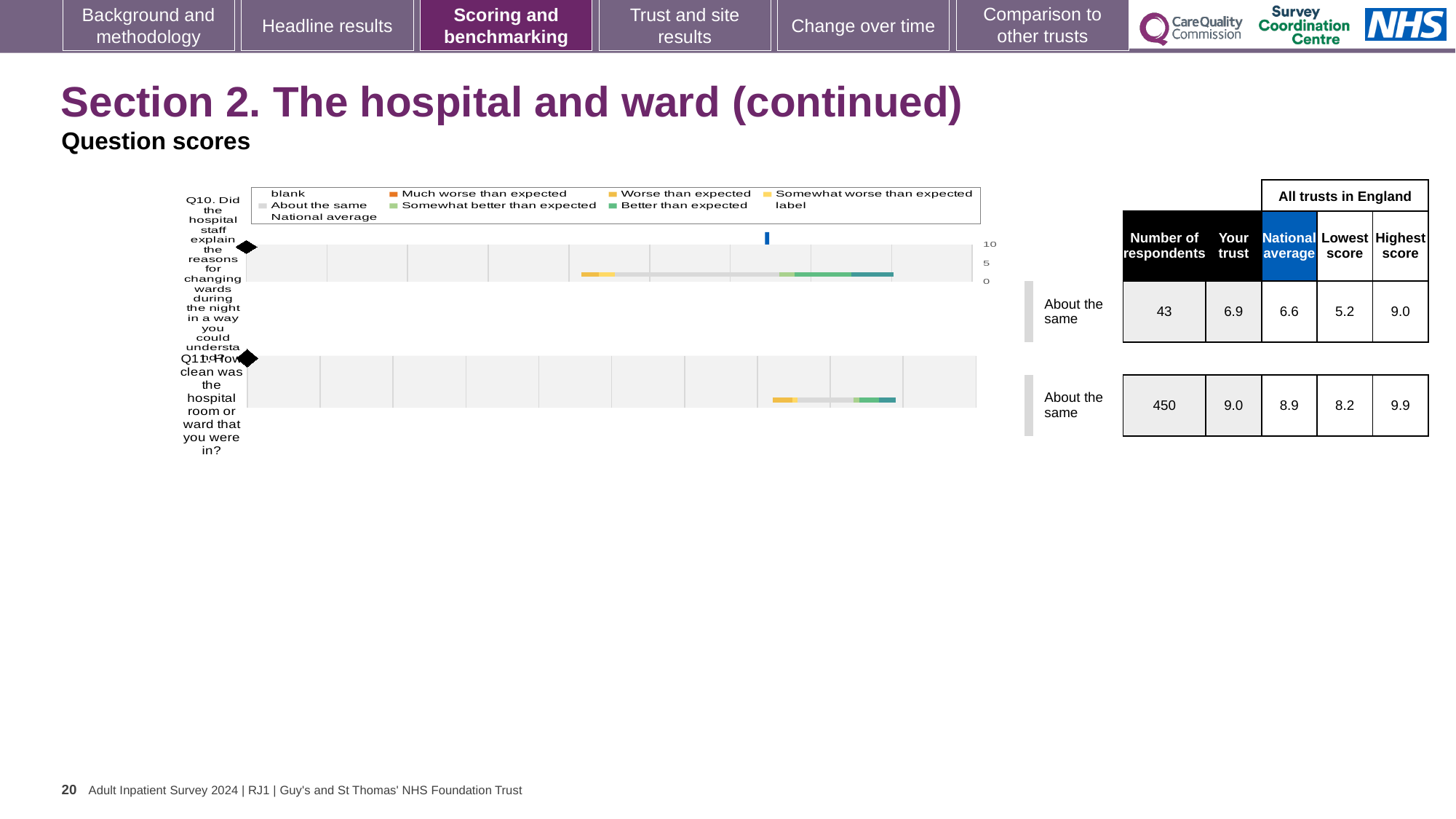
What is the difference between the highest and lowest scores among all trusts for Q10? 3.8 What is the highest score among all trusts in England for Q10? 9.0 What is the trust's score for Q11 (how clean was the hospital room or ward)? 9.0 What benchmark category is shown for Q11 (how clean was the hospital room or ward)? About the same For Q11, which is larger: the trust's score or the national average? The trust's score (9.0) How many questions are plotted on this slide? 2 What is the national average score for Q10 (explaining reasons for changing wards during the night)? 6.6 What is the lowest score among all trusts in England for Q11? 8.2 What is the difference between the trust's score and the national average for Q10? 0.3 How many respondents answered Q11 (how clean was the hospital room or ward)? 450 What is the trust's score for Q10 (explaining reasons for changing wards during the night)? 6.9 How many respondents answered Q10 (explaining reasons for changing wards during the night)? 43